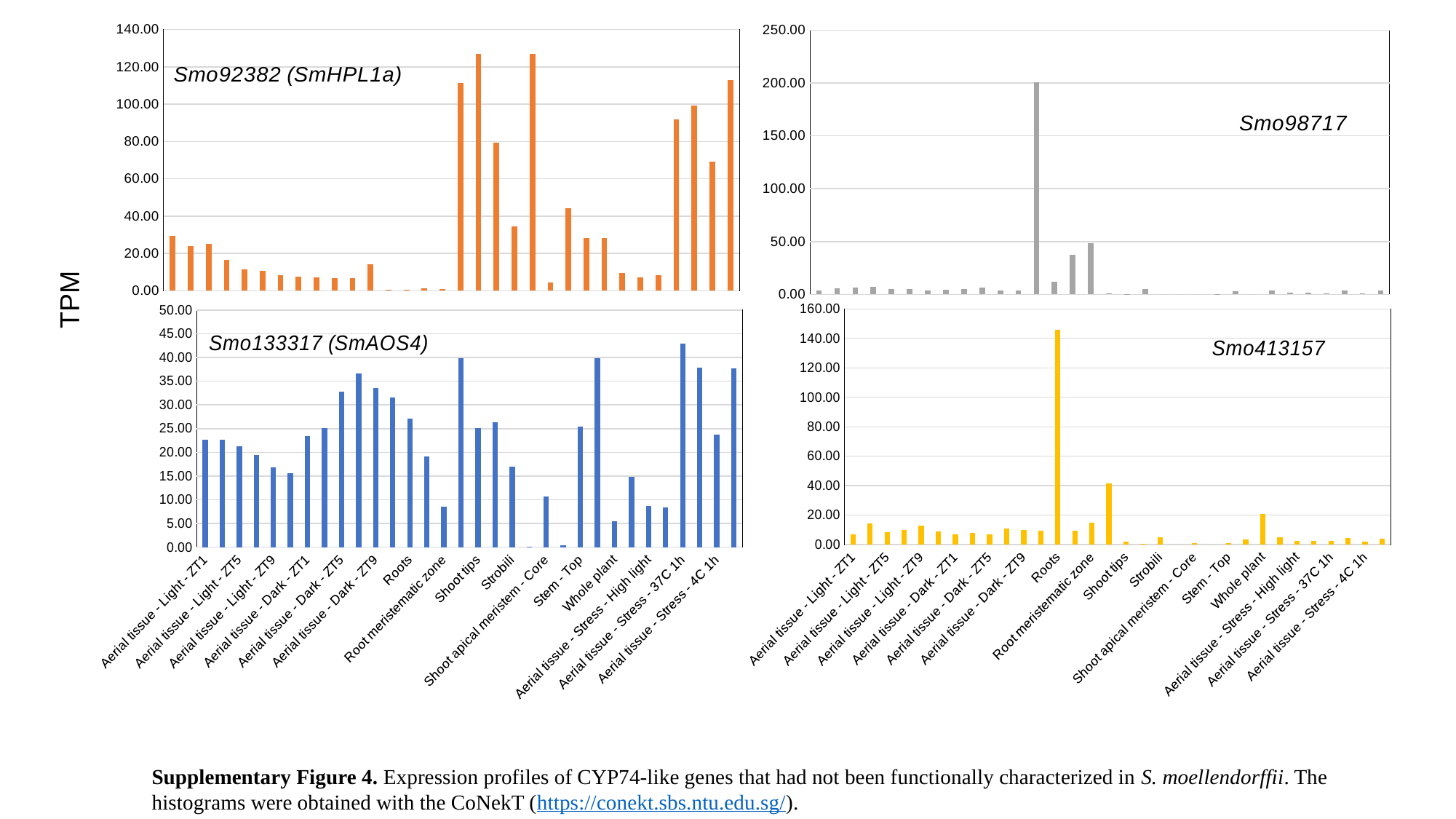
What kind of chart is used for Smo92382 (SmHPL1a)? Bar chart In the Smo133317 (SmAOS4) chart, is the value for Aerial tissue - Light - ZT1 greater or less than 20? greater In the Smo413157 chart, is the value for Whole plant greater or less than 40? less In the Smo98717 chart, is the tallest bar greater or less than 150? greater How many charts are shown on the slide? 4 What is the maximum value shown on the y axis of the Smo133317 (SmAOS4) chart? 50.00 Which chart has the highest value shown on its y axis? Smo98717 What is the maximum value shown on the y axis of the Smo413157 chart? 160.00 What is the label on the shared y axis of the charts? TPM